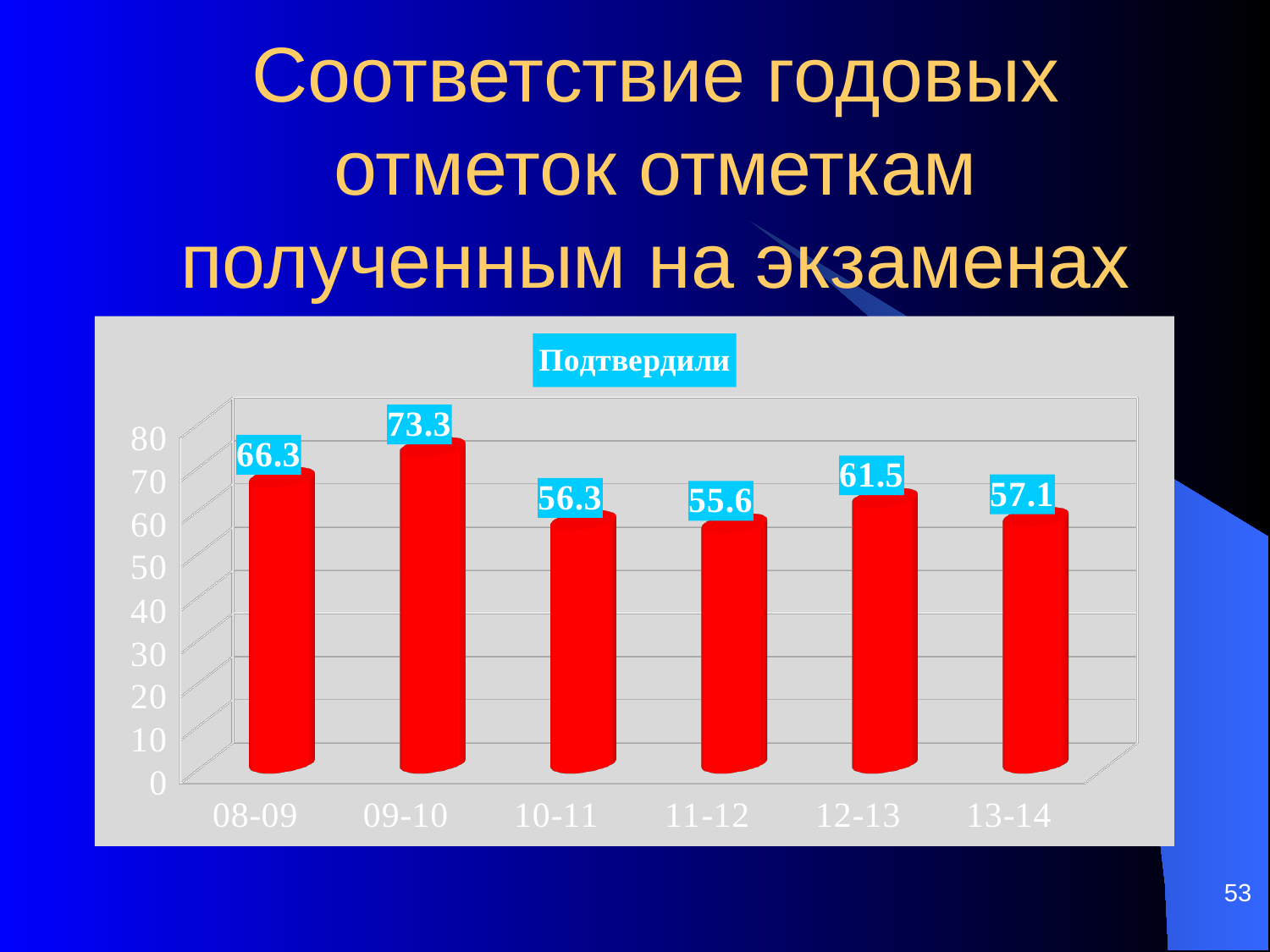
How many years are shown on the x axis? 6 Which year has the highest value? 09-10 What is the value for 13-14? 57.1 What is the title of the chart? Подтвердили Which is larger, the value for 08-09 or the value for 12-13? 08-09 What is the difference between the values for 12-13 and 13-14? 4.4 Is the value for 10-11 greater or less than 60? less What is the value for 08-09? 66.3 What is the value for 11-12? 55.6 Which year has the lowest value? 11-12 What kind of chart is this? bar chart What is the difference between the values for 09-10 and 10-11? 17.0